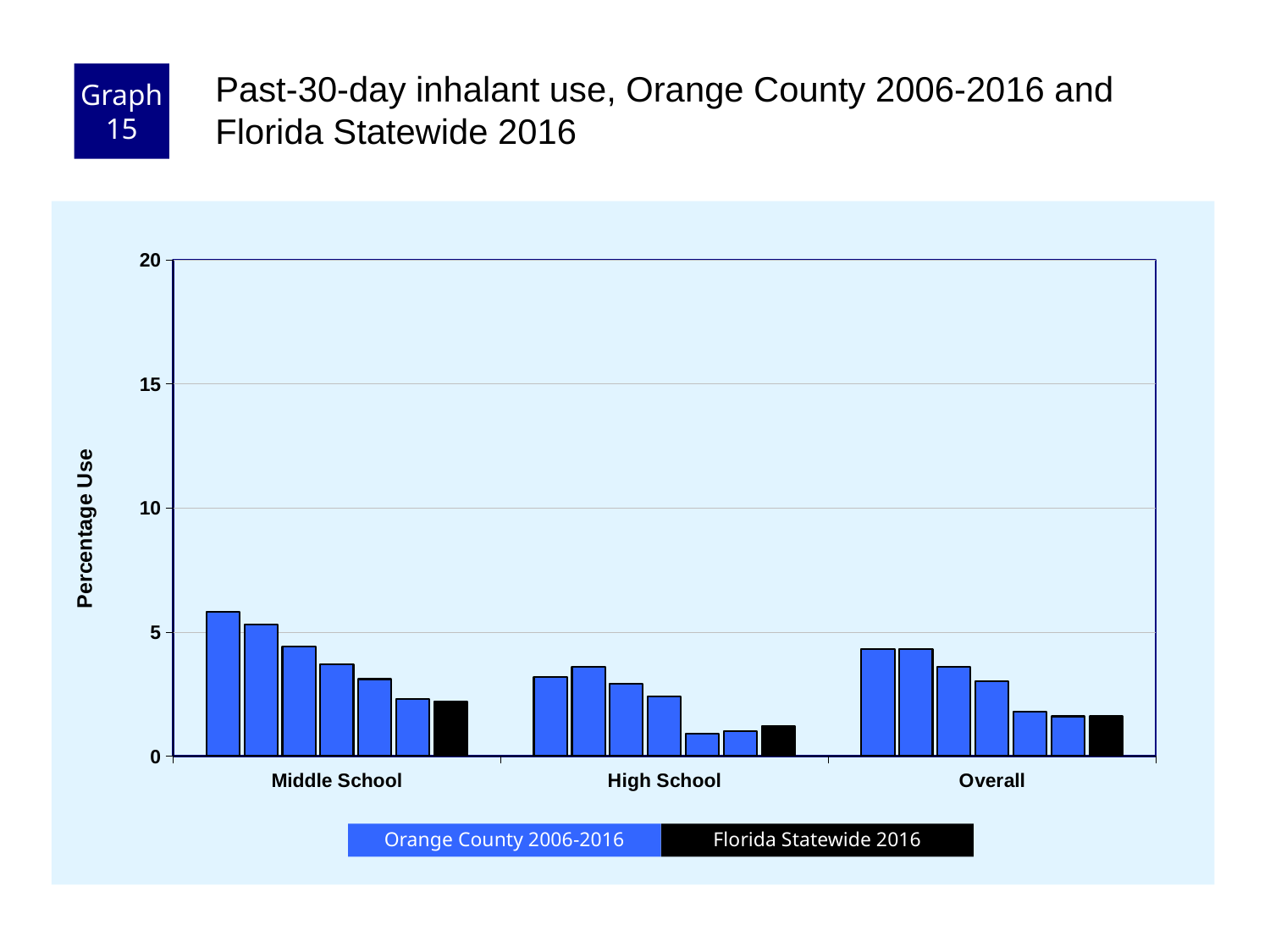
Do the Orange County bars for Middle School generally rise or fall from 2006 to 2016? fall What colour represents Florida Statewide 2016 in the legend? Black What kind of chart is shown on the slide? Bar chart Which is larger: the first Orange County bar for Overall or the first Orange County bar for High School? Overall How many school-level categories are shown on the x axis? 3 How many series does the legend list? 2 Is the Florida Statewide 2016 value for High School greater or less than 5? less Is the value of the tallest Middle School bar greater or less than 5? greater Are any bars on the chart greater than 10? No What is the label on the y axis? Percentage Use Which is larger: the first Orange County bar for Middle School or the first Orange County bar for High School? Middle School Which category has the tallest bar overall? Middle School